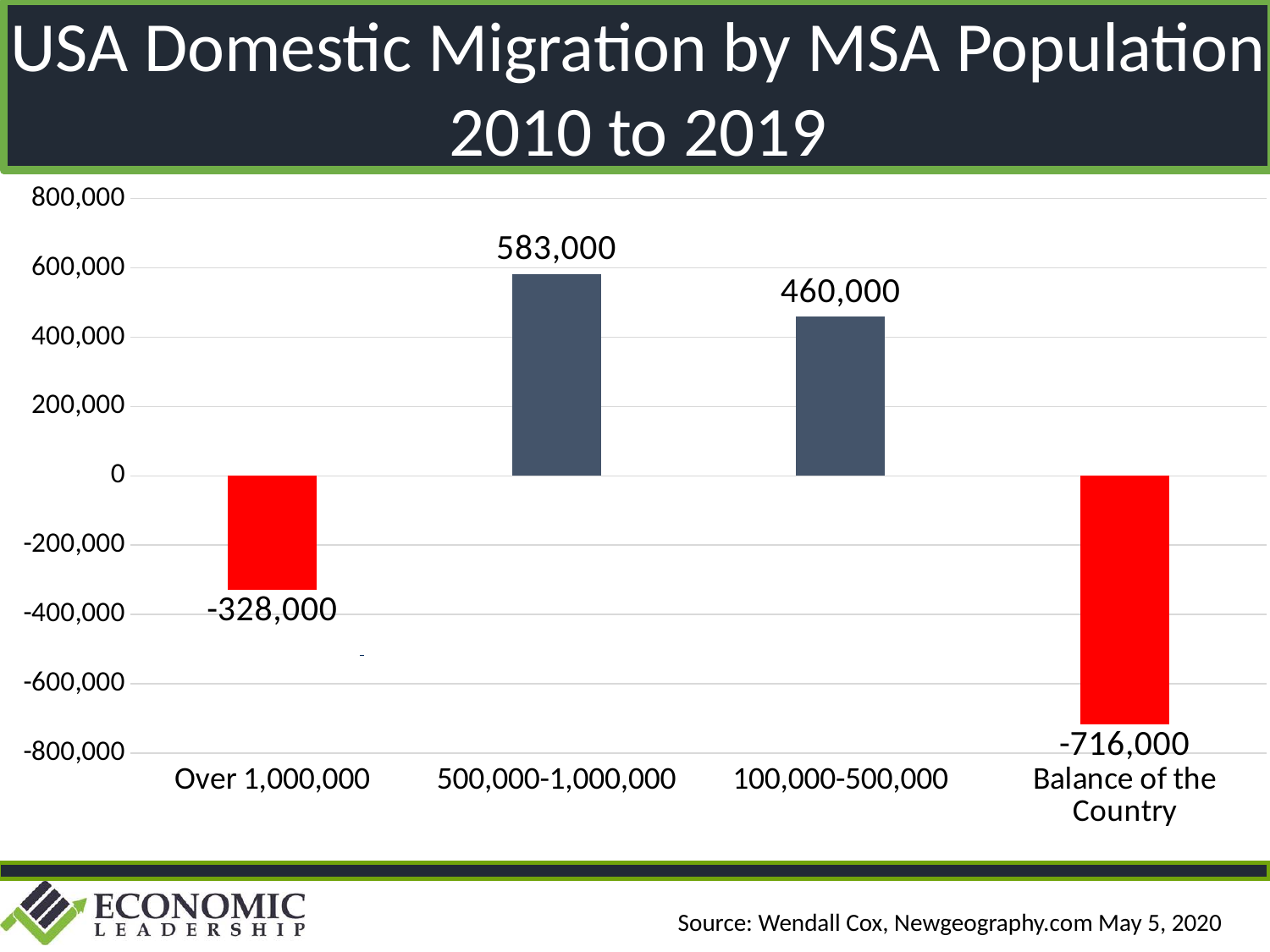
Which category has the lowest domestic migration value? Balance of the Country How many categories are shown on the x axis? 4 Which is larger, the value for 100,000-500,000 or the value for Over 1,000,000? 100,000-500,000 What is the title of the chart? USA Domestic Migration by MSA Population 2010 to 2019 Which category has the highest domestic migration value? 500,000-1,000,000 What is the domestic migration value for the 500,000-1,000,000 MSA population category? 583,000 What is the value shown for Balance of the Country? -716,000 What is the difference between the values for 500,000-1,000,000 and 100,000-500,000? 123,000 What colour are the bars with negative values? Red What is the domestic migration value for the Over 1,000,000 category? -328,000 What kind of chart is shown on the slide? Bar chart What is the value for the 100,000-500,000 category? 460,000